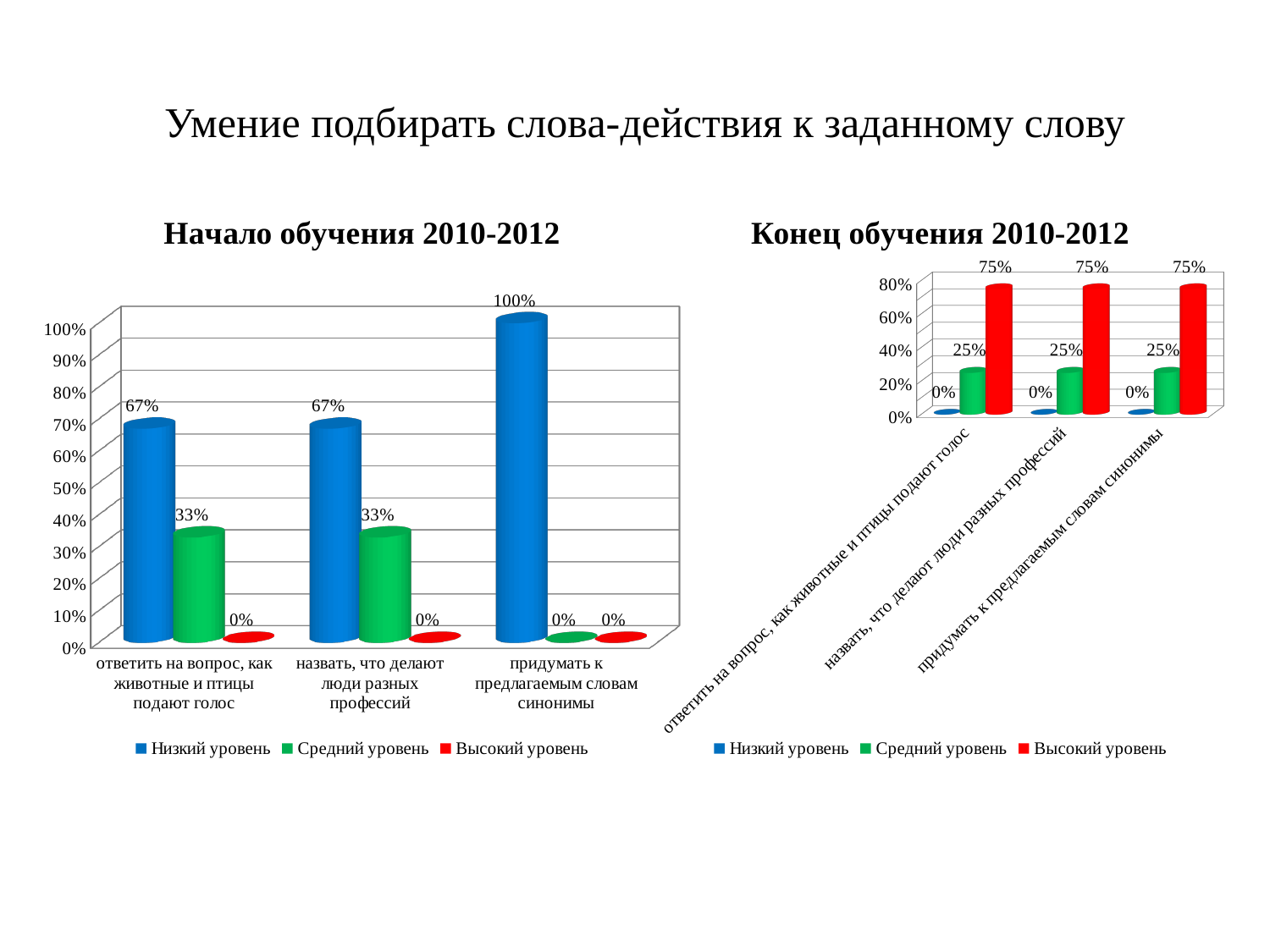
In the chart titled "Начало обучения 2010-2012", what is the value for "Средний уровень" in the category "ответить на вопрос, как животные и птицы подают голос"? 33% In the chart titled "Конец обучения 2010-2012", what is the value for "Средний уровень" in the category "придумать к предлагаемым словам синонимы"? 25% In the chart titled "Начало обучения 2010-2012", which category has the highest value for "Низкий уровень"? придумать к предлагаемым словам синонимы In the chart titled "Конец обучения 2010-2012", what is the difference between the "Высокий уровень" and "Средний уровень" values in the category "ответить на вопрос, как животные и птицы подают голос"? 50% In the chart titled "Конец обучения 2010-2012", which is larger in the category "назвать, что делают люди разных профессий": "Средний уровень" or "Высокий уровень"? Высокий уровень In the chart titled "Начало обучения 2010-2012", what is the difference between the "Низкий уровень" and "Средний уровень" values in the category "назвать, что делают люди разных профессий"? 34% In the chart titled "Конец обучения 2010-2012", what is the value for "Высокий уровень" in the category "назвать, что делают люди разных профессий"? 75% How many series does the legend of the chart titled "Конец обучения 2010-2012" list? 3 How many categories are shown on the x axis of the chart titled "Начало обучения 2010-2012"? 3 In the chart titled "Конец обучения 2010-2012", which series is shown in red in the legend? Высокий уровень What type of chart is the chart titled "Начало обучения 2010-2012"? Bar chart In the chart titled "Начало обучения 2010-2012", what is the value for "Низкий уровень" in the category "придумать к предлагаемым словам синонимы"? 100%